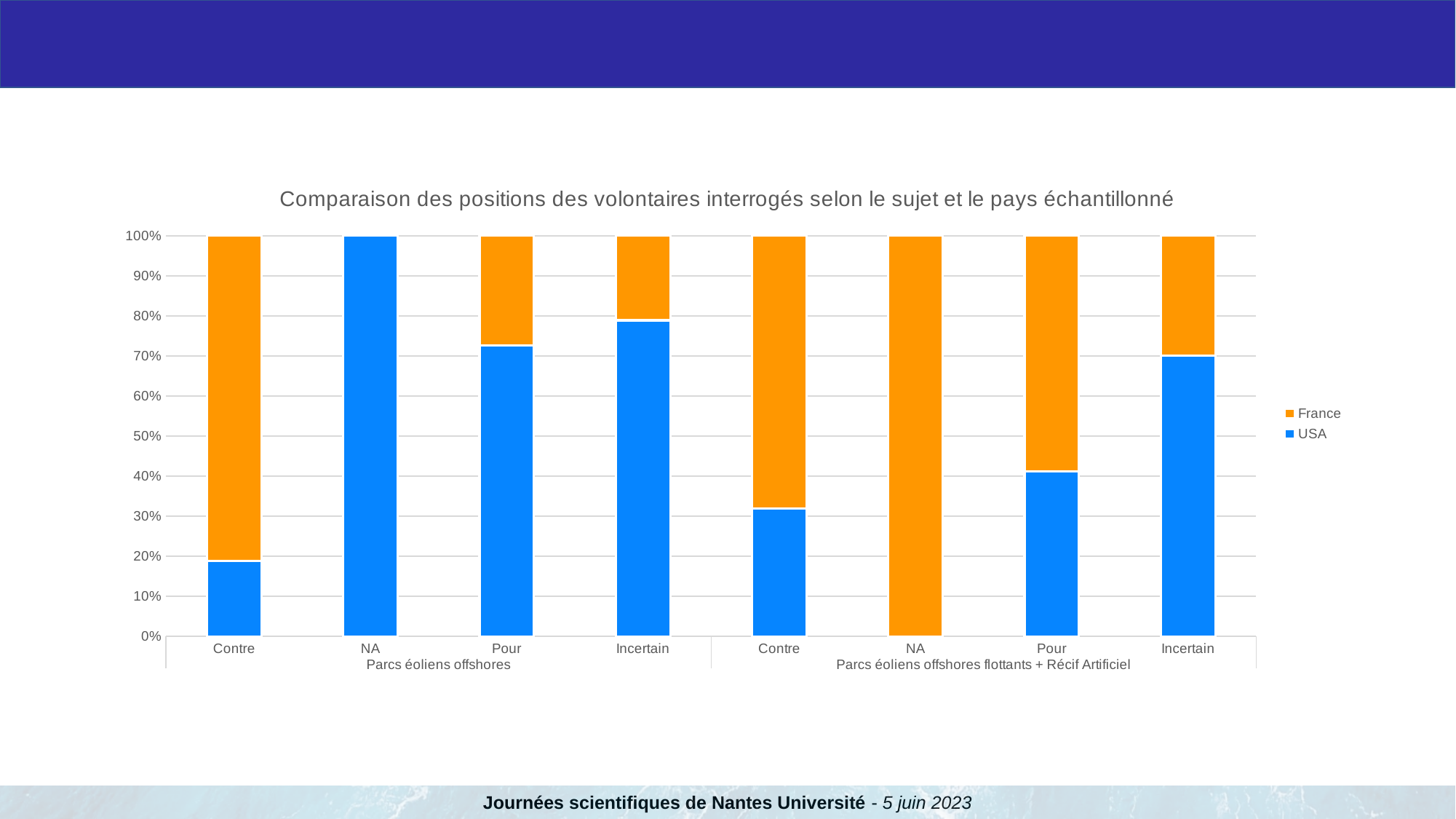
Is the USA share of the Contre bar under Parcs éoliens offshores flottants + Récif Artificiel greater or less than 20%? greater How many series does the legend list? 2 What kind of chart is shown on the slide? Stacked bar chart Is the USA share of the Pour bar under Parcs éoliens offshores greater or less than 60%? greater Under Parcs éoliens offshores flottants + Récif Artificiel, which category has the largest France share? NA Under Parcs éoliens offshores, which category has the largest USA share? NA Is the USA share of the Contre bar under Parcs éoliens offshores greater or less than 30%? less Which colour represents the USA series in the chart? Blue What is the title of the chart? Comparaison des positions des volontaires interrogés selon le sujet et le pays échantillonné Is the USA share of the Pour bar larger under Parcs éoliens offshores or under Parcs éoliens offshores flottants + Récif Artificiel? Parcs éoliens offshores How many bars are plotted in the chart? 8